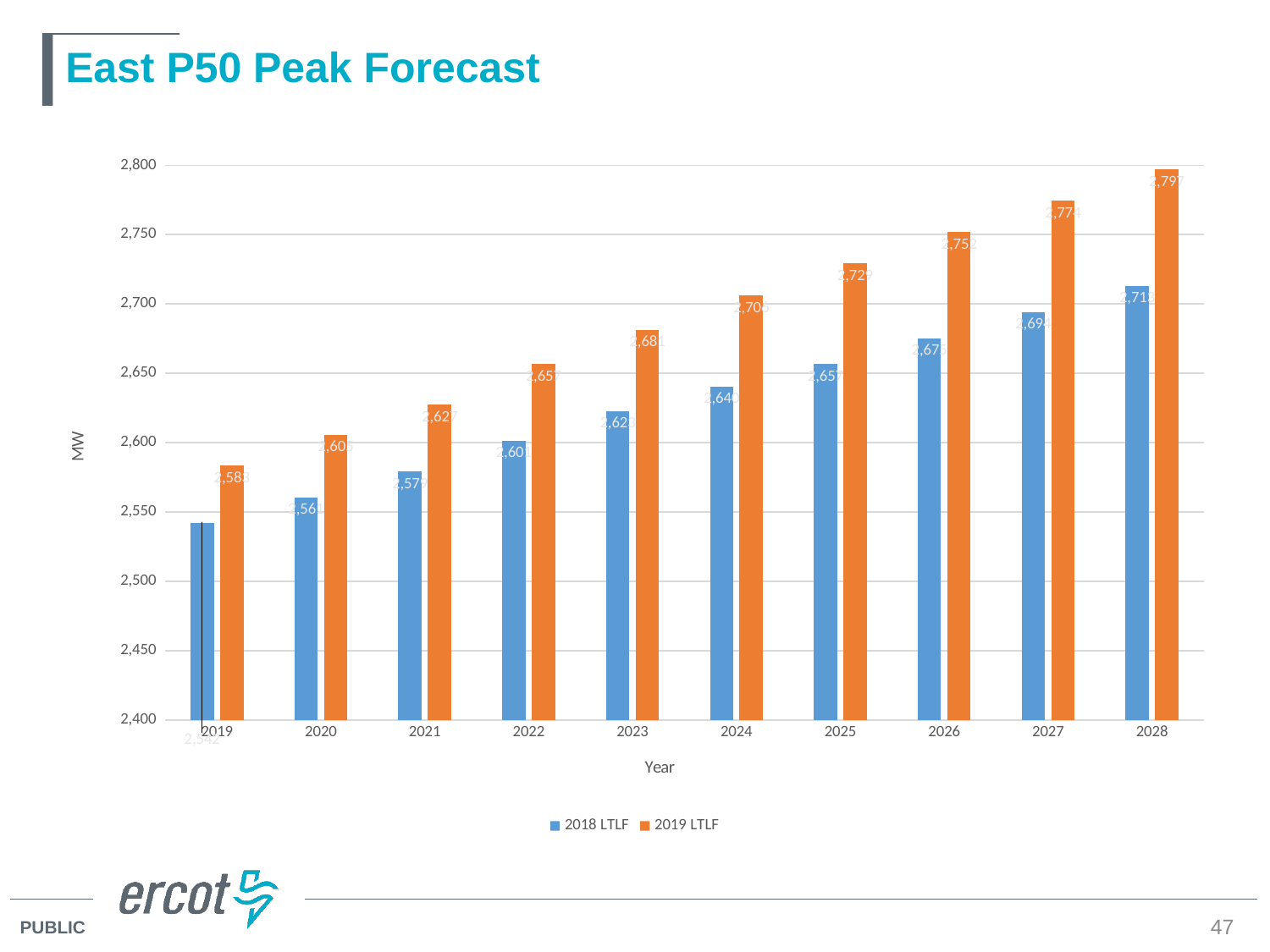
How many series does the legend list? 2 Which year has the highest 2019 LTLF value? 2028 What is the 2019 LTLF value for 2026? 2,752 How many years are shown on the x axis? 10 Is the 2018 LTLF value for 2021 greater or less than 2,600? less What is the 2018 LTLF value for 2024? 2,640 What kind of chart is shown on the slide? Bar chart Do the 2019 LTLF values rise or fall from 2019 to 2028? Rise What label is shown on the y axis? MW Which year has the lowest 2018 LTLF value? 2019 In 2028, which series has the larger value, 2018 LTLF or 2019 LTLF? 2019 LTLF Is the 2019 LTLF value for 2027 greater or less than 2,750? greater